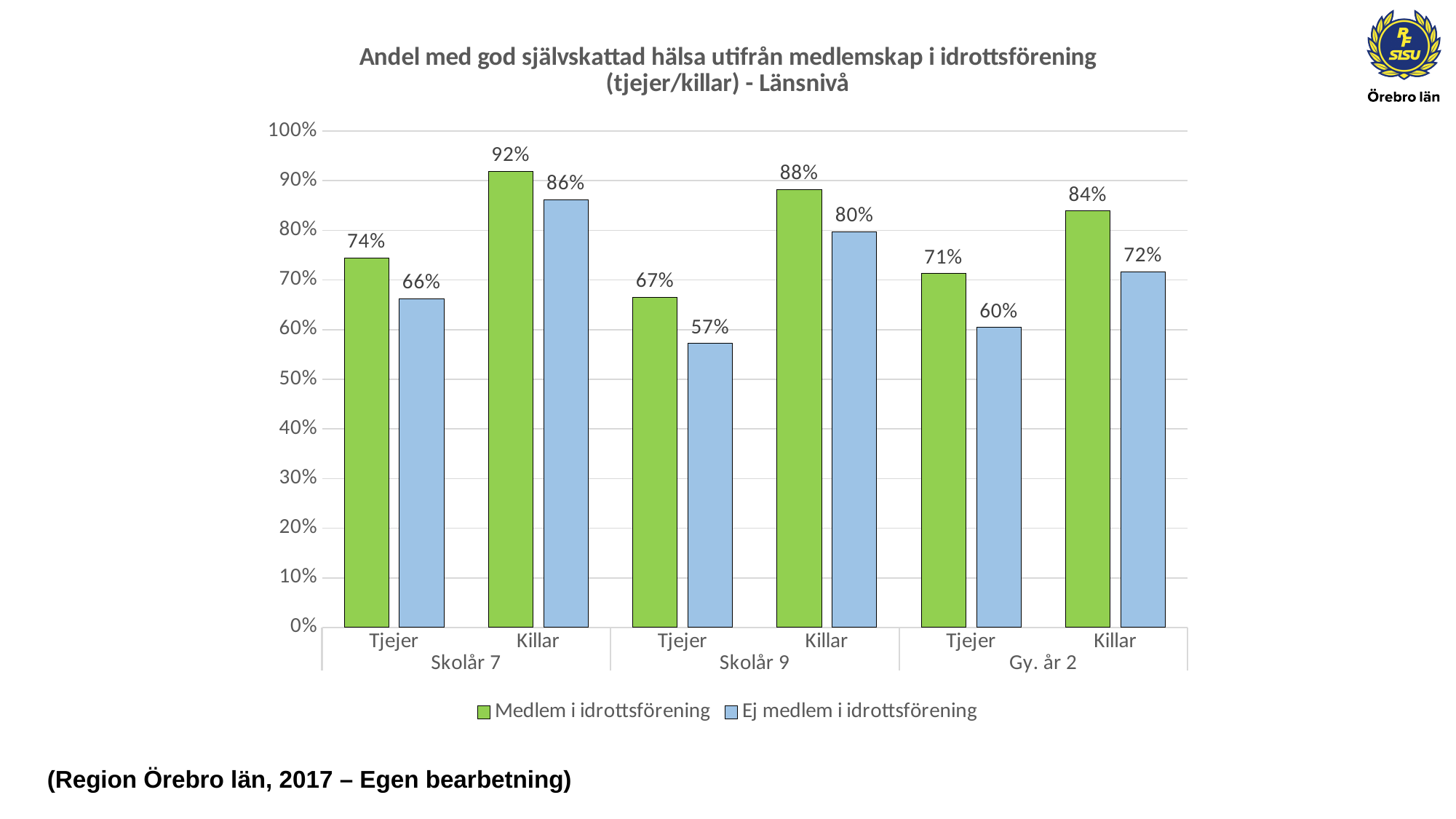
What is the value for Tjejer in Gy. år 2 for the series Medlem i idrottsförening? 71% What is the difference between Medlem i idrottsförening and Ej medlem i idrottsförening for Killar in Gy. år 2? 12 percentage points What kind of chart is shown on the slide? Bar chart What is the value for Tjejer in Skolår 9 for the series Ej medlem i idrottsförening? 57% Which is larger for Tjejer in Skolår 7: Medlem i idrottsförening or Ej medlem i idrottsförening? Medlem i idrottsförening What is the difference between Killar and Tjejer for Ej medlem i idrottsförening in Skolår 9? 23 percentage points Which colour represents Ej medlem i idrottsförening in the chart? Blue How many groups (bar pairs) are shown along the x axis? 6 How many series does the legend list? 2 Which group has the highest value for Medlem i idrottsförening? Killar, Skolår 7 Which group has the lowest value for Ej medlem i idrottsförening? Tjejer, Skolår 9 What is the value for Killar in Skolår 7 for the series Medlem i idrottsförening? 92%